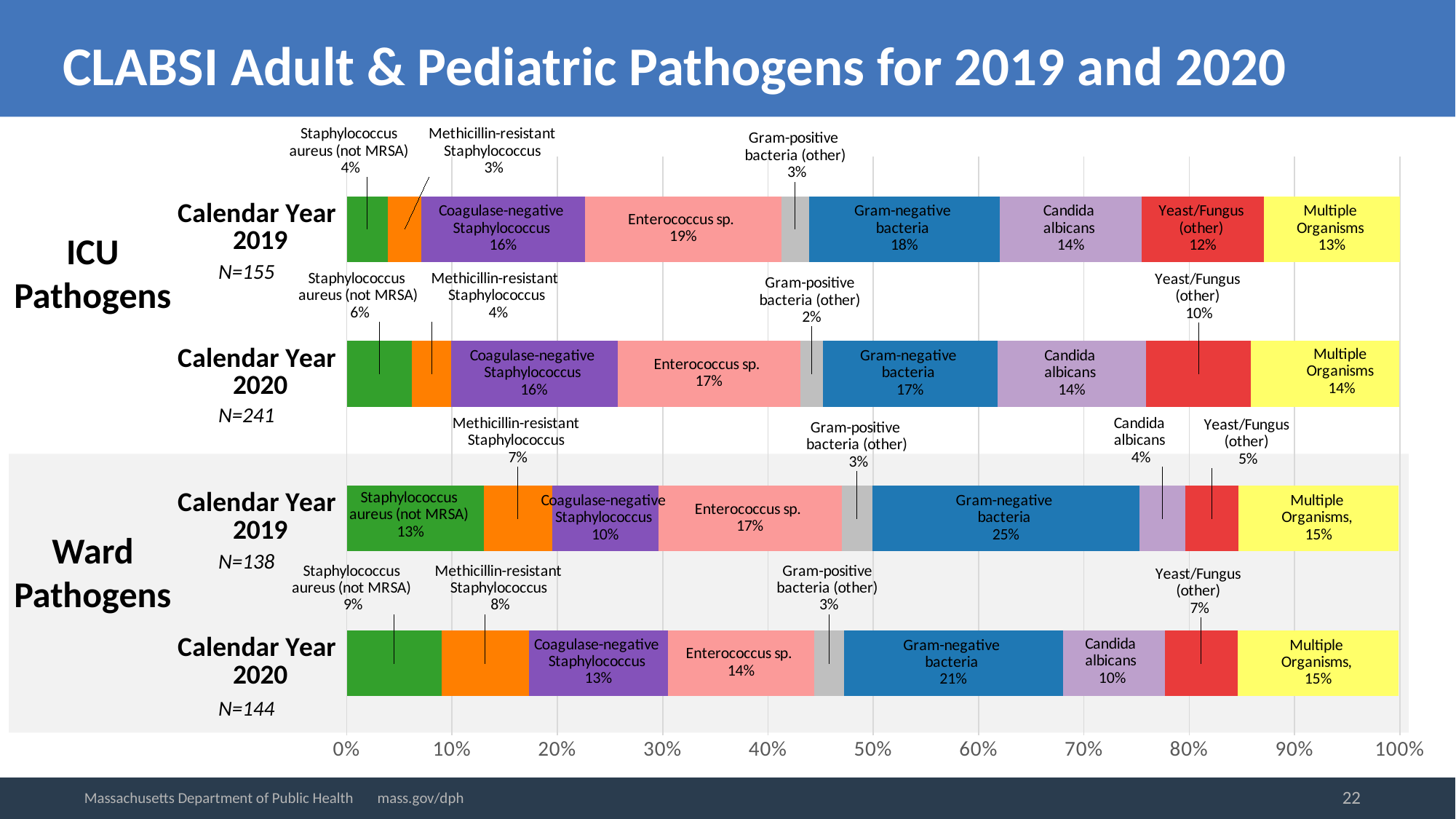
What is the difference in percentage points between Gram-negative bacteria in Ward 2019 and Ward 2020? 4 What percentage of ICU pathogens in Calendar Year 2019 were Enterococcus sp.? 19% Which is larger: the share of Staphylococcus aureus (not MRSA) in Ward 2019 or in Ward 2020? Ward 2019 How many pathogen categories make up each stacked bar? 9 What percentage of Ward pathogens in Calendar Year 2019 were Gram-negative bacteria? 25% What is the title of the slide? CLABSI Adult & Pediatric Pathogens for 2019 and 2020 How many calendar-year bars are shown on the chart? 4 Which pathogen category has the largest share of Ward pathogens in Calendar Year 2020? Gram-negative bacteria What is the N value for ICU pathogens in Calendar Year 2020? N=241 Which pathogen category has the smallest share of ICU pathogens in Calendar Year 2020? Gram-positive bacteria (other) What type of chart is shown on the slide? Stacked bar chart What percentage of Ward pathogens in Calendar Year 2020 were Candida albicans? 10%